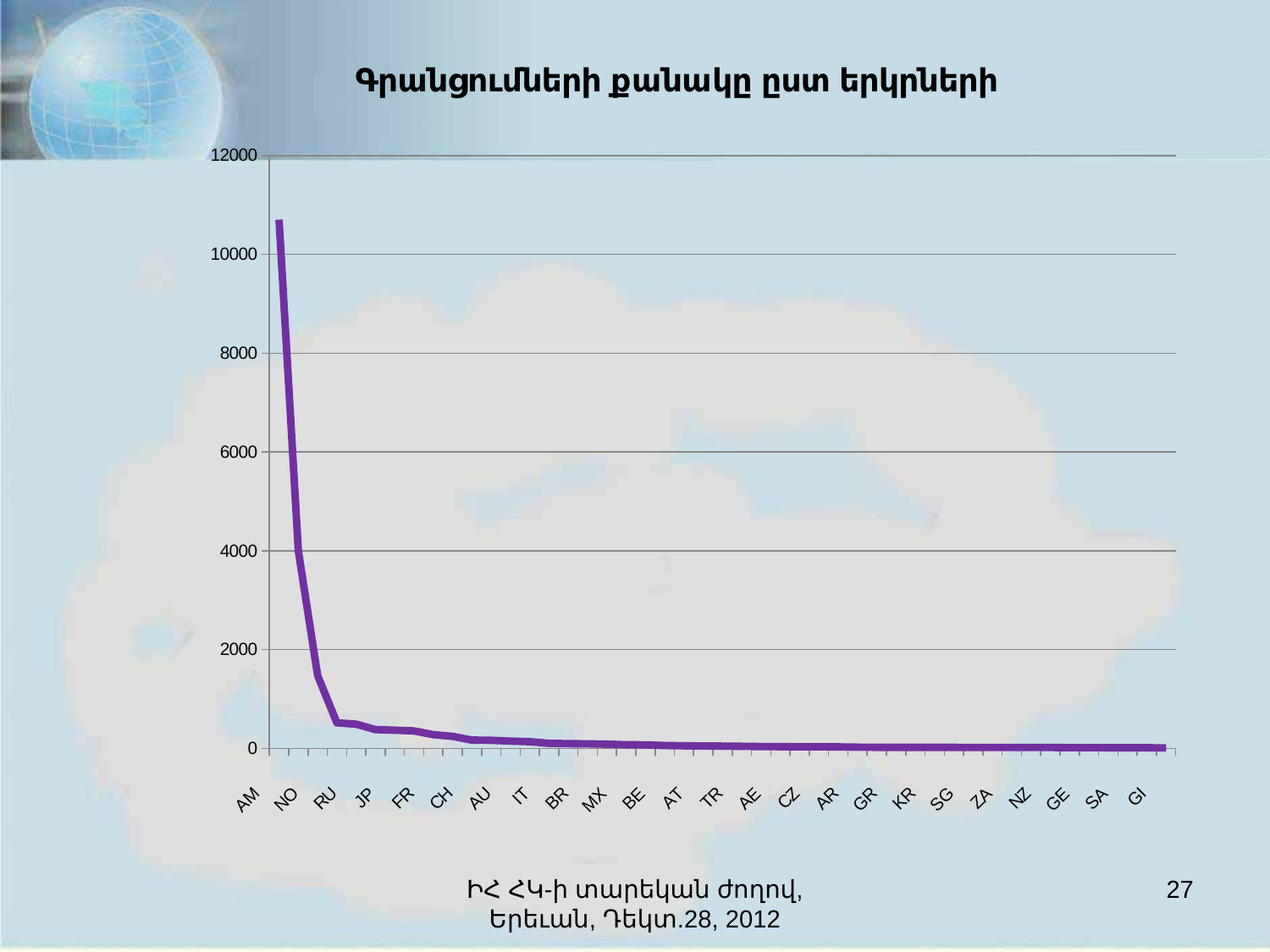
Is the value for AM greater or less than 10000? greater Which has a larger value, AM or NO? AM Which country has the highest value on the chart? AM Is the value for JP greater or less than 4000? less What kind of chart is shown on the slide? line chart How many country labels are shown on the x axis? 24 What is the highest value shown on the y axis? 12000 Is the value for RU greater or less than 2000? less Which has a larger value, NO or RU? NO Do the values rise or fall moving from left to right along the x axis? fall What is the title of the chart? Գրանցումների քանակը ըստ երկրների